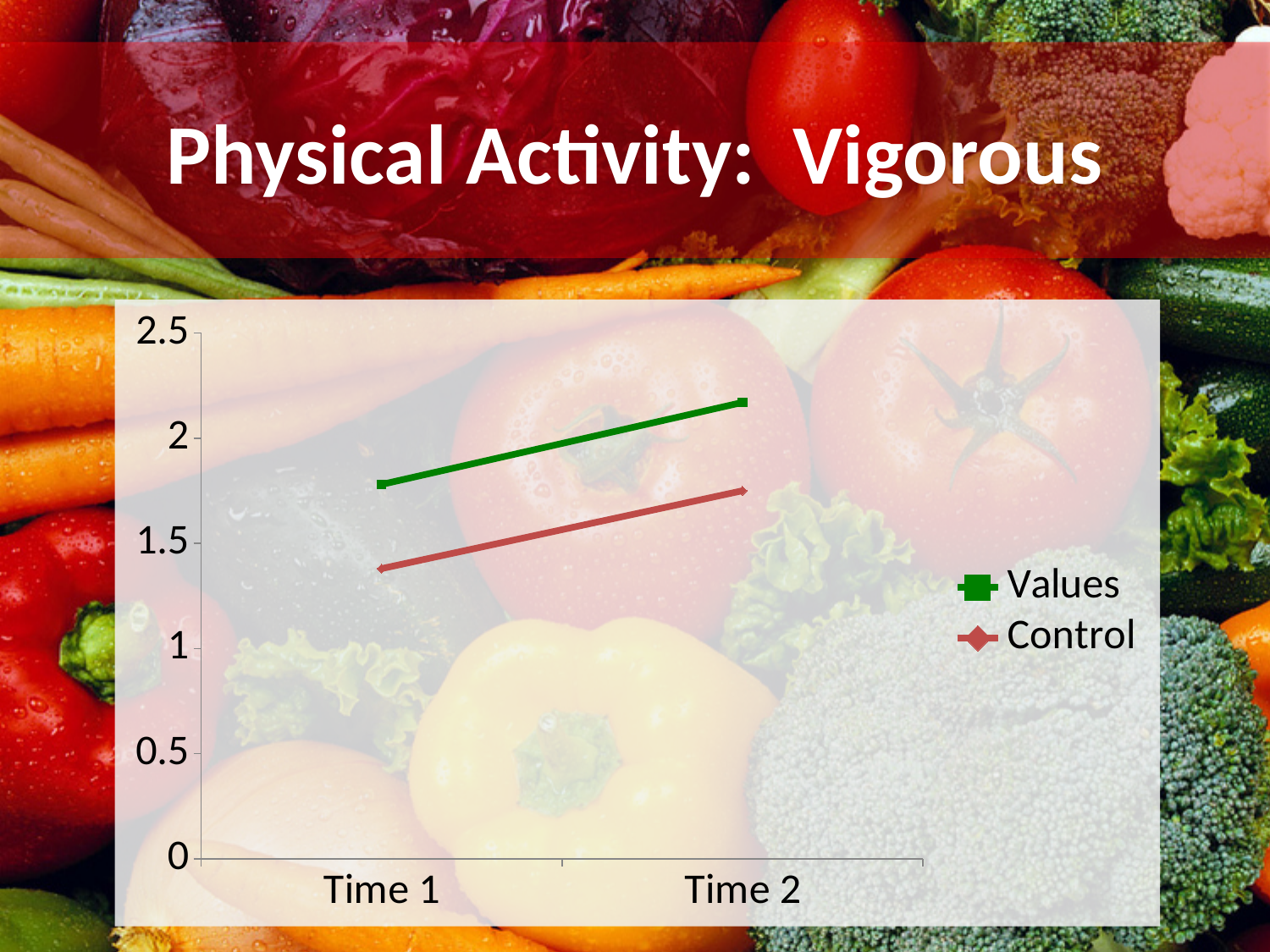
What colour is the line for the Control series? red Does the Values series rise or fall from Time 1 to Time 2? rise How many series does the legend list? 2 Does the Control series rise or fall from Time 1 to Time 2? rise What kind of chart is shown on the slide? line chart Is the value for Control at Time 1 greater or less than 1.5? less Is the value for Control at Time 2 greater or less than 2? less Which series is higher at Time 1, Values or Control? Values Is the value for Values at Time 2 greater or less than 2? greater How many time points are shown on the x axis? 2 Which series is higher at Time 2, Values or Control? Values